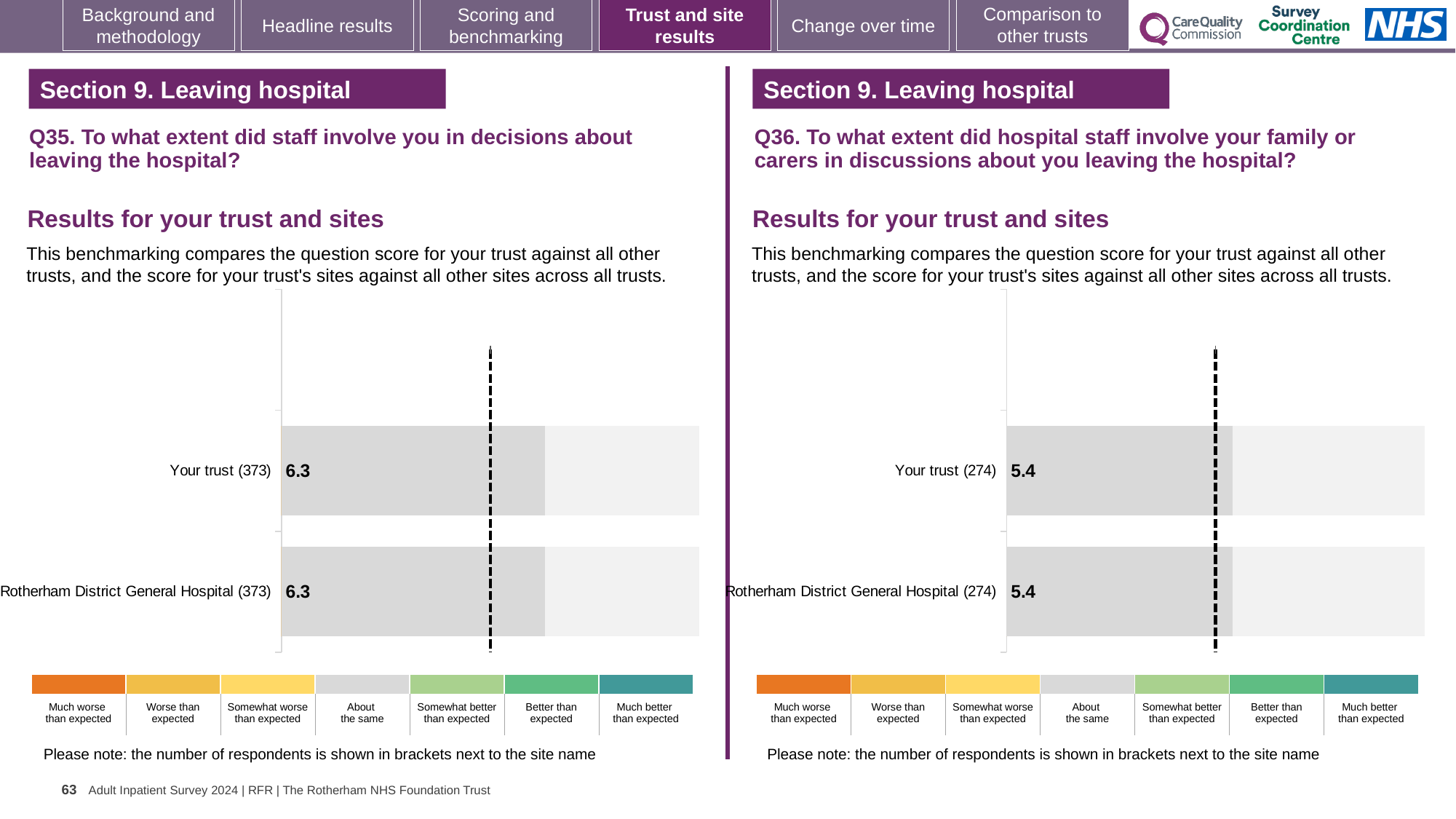
On the Q35 chart (left), what is the score for Rotherham District General Hospital (373)? 6.3 How many bars are plotted on the Q35 chart (left)? 2 On the Q35 chart (left), what is the difference between the score for Your trust and the score for Rotherham District General Hospital? 0.0 How many benchmark categories does the colour key below the Q35 chart (left) list? 7 On the Q36 chart (right), what is the score for Rotherham District General Hospital (274)? 5.4 On the Q35 chart (left), what is the score for Your trust (373)? 6.3 On the Q36 chart (right), what is the difference between the score for Your trust and the score for Rotherham District General Hospital? 0.0 What kind of chart is used on the Q35 chart (left)? Bar chart Which benchmark category does the colour of the bars on the Q36 chart (right) correspond to in the key? About the same How many respondents are shown in brackets for Your trust on the Q36 chart (right)? 274 On the Q36 chart (right), what is the score for Your trust (274)? 5.4 How many bars are plotted on the Q36 chart (right)? 2